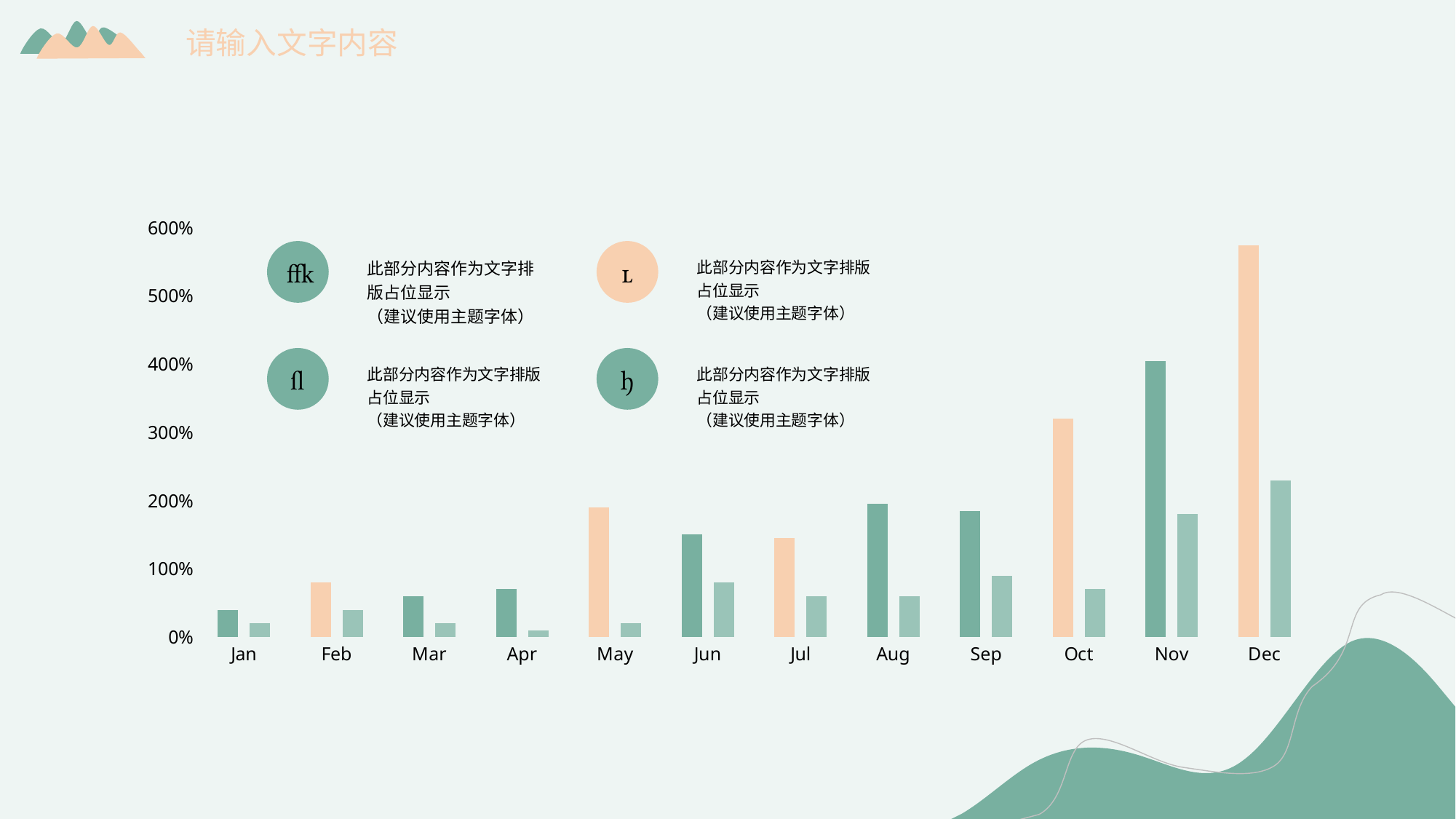
Is the value of the first (left) bar for Nov greater or less than 300%? greater Which is larger, the first (left) bar for Nov or the first (left) bar for Oct? Nov Which month has the shortest first (left) bar in the chart? Jan Which month has the tallest bar in the chart? Dec Is the value of the first (left) bar for Jan greater or less than 100%? less Is the value of the tallest bar for Dec greater or less than 500%? greater Which month has the shortest second (right, light green) bar in the chart? Apr Do the first (left) bars generally rise or fall from Jan to Dec? rise What kind of chart is shown on the slide? bar chart What colour is the tallest bar for Dec? orange How many months are shown on the x axis of the chart? 12